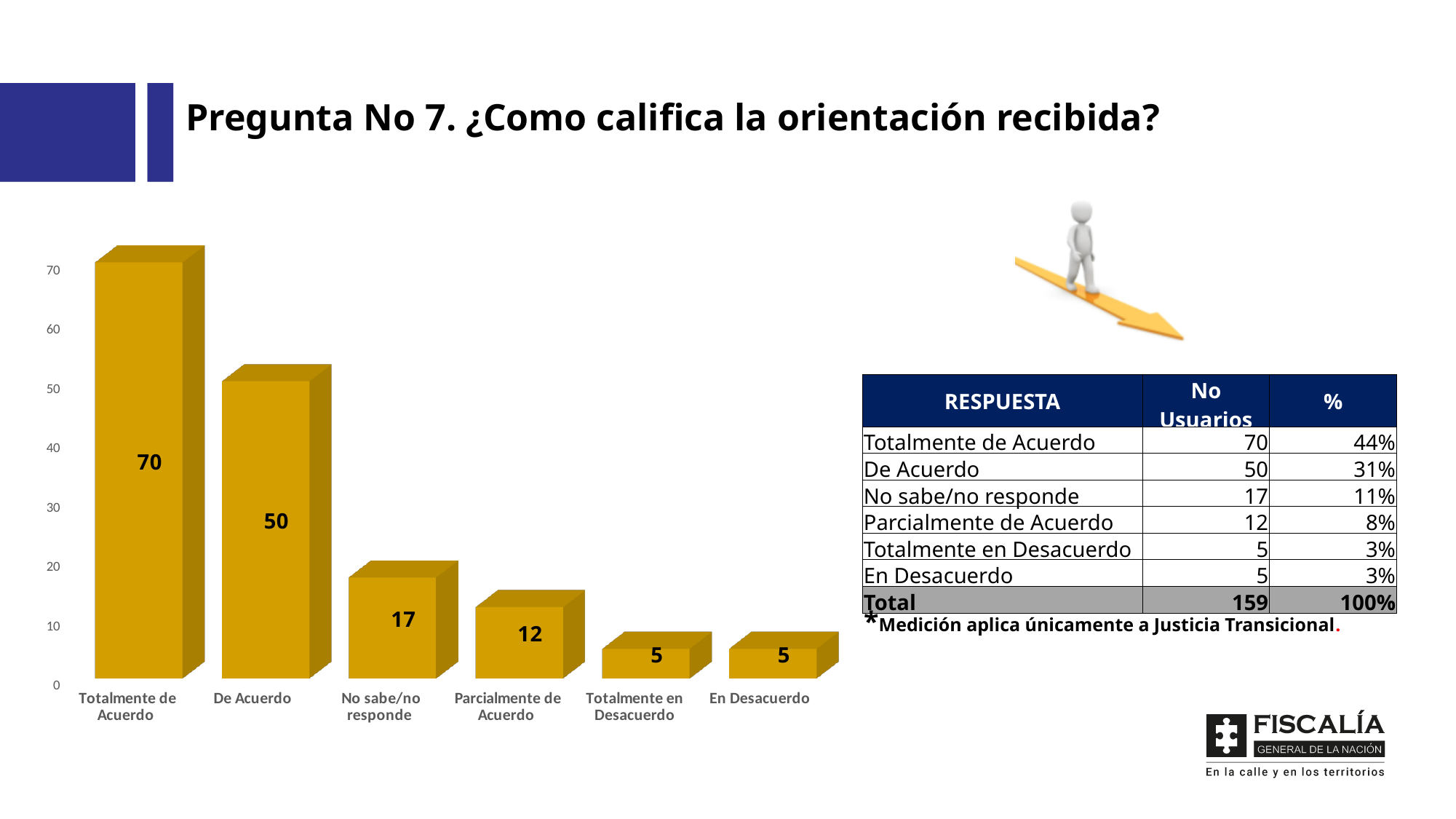
What is the difference between the values for "Totalmente de Acuerdo" and "De Acuerdo"? 20 Which is larger, the value for "De Acuerdo" or the value for "No sabe/no responde"? De Acuerdo What kind of chart is shown on the slide? Bar chart What is the value for "De Acuerdo"? 50 What is the value for "No sabe/no responde"? 17 Which category has the highest value? Totalmente de Acuerdo How many categories are shown on the x axis of the chart? 6 What is the value for "Totalmente en Desacuerdo"? 5 What is the difference between the values for "No sabe/no responde" and "Parcialmente de Acuerdo"? 5 Do the values rise or fall from left to right along the x axis? Fall What is the value for "Totalmente de Acuerdo"? 70 What is the value for "Parcialmente de Acuerdo"? 12